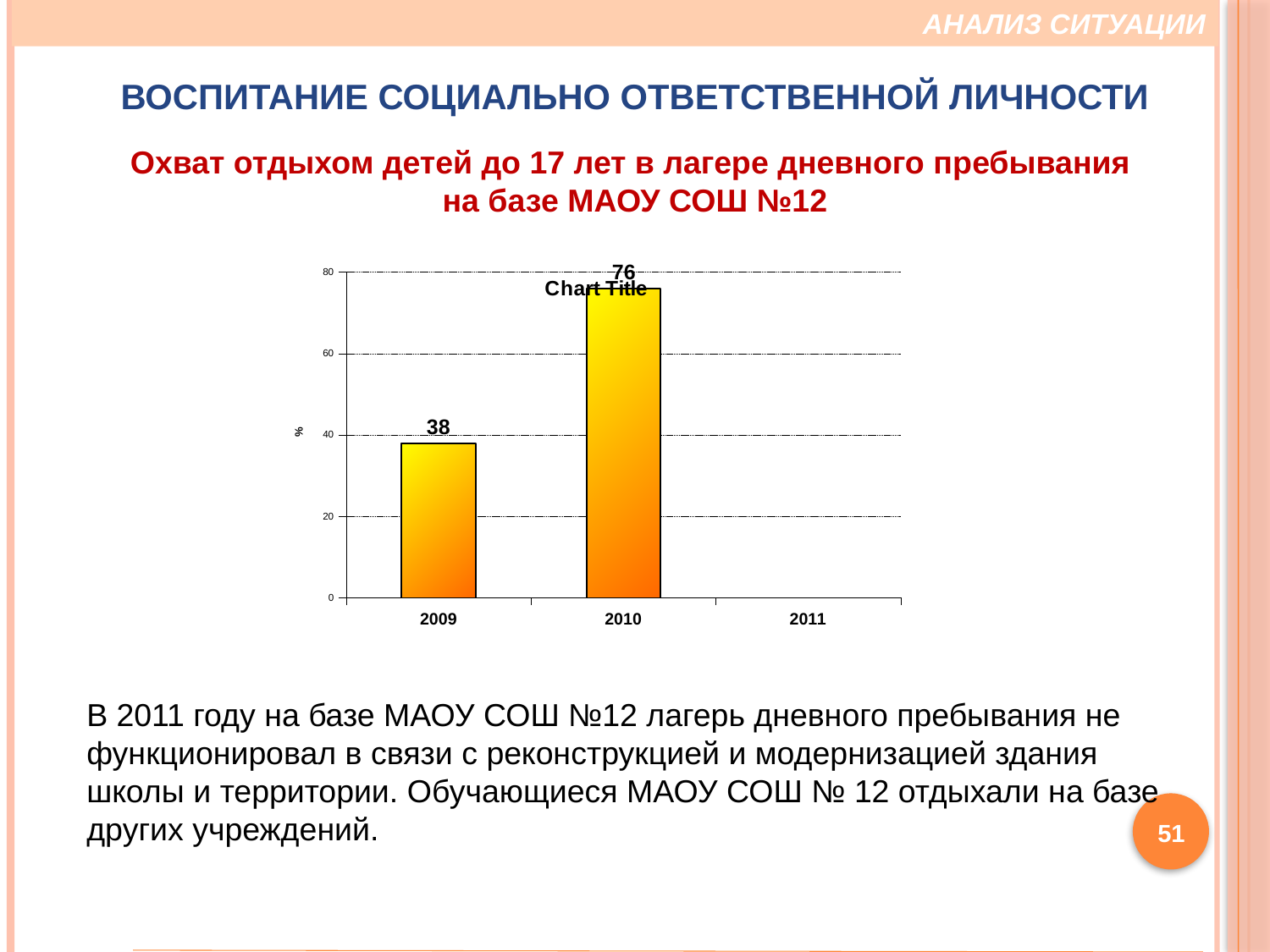
Which is larger, the value for 2009 or the value for 2010? 2010 What is the value for 2010? 76 How many bars are plotted on the chart? 2 What kind of chart is shown? bar chart Is the value for 2009 greater or less than 40? less What is the difference between the values for 2010 and 2009? 38 Which year with a plotted bar has the lowest value? 2009 Which year has the highest value? 2010 Is the value for 2010 greater or less than 60? greater What is the label on the vertical axis? % How many years are shown on the x axis? 3 What is the value for 2009? 38